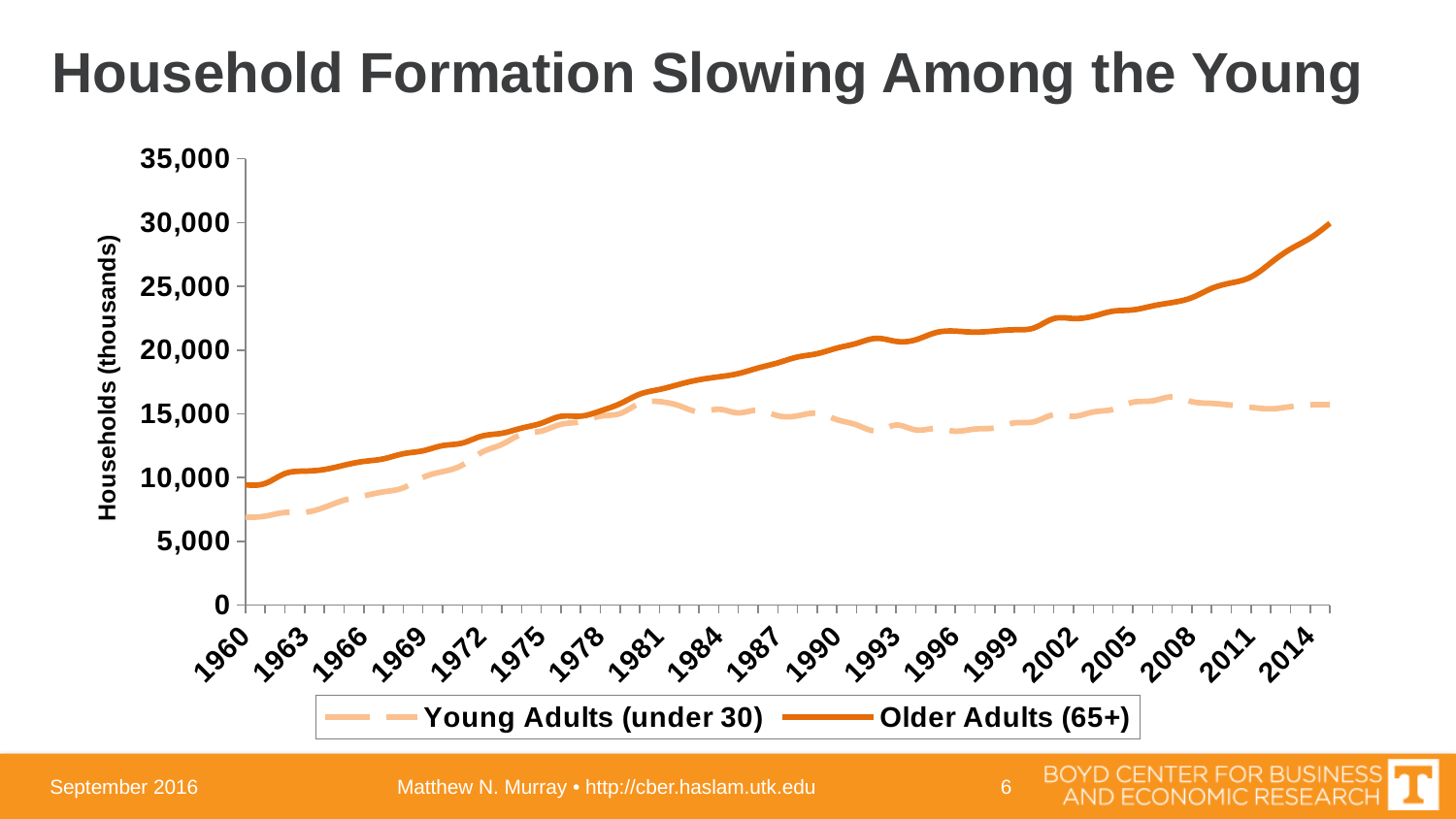
Is the value for Young Adults (under 30) in 1960 greater or less than 10,000? less Is the value for Young Adults (under 30) in 1993 greater or less than 15,000? less In 2014, which series has the higher value, Young Adults (under 30) or Older Adults (65+)? Older Adults (65+) Is the value for Older Adults (65+) in 2005 greater or less than 20,000? greater What kind of chart is shown on the slide? Line chart Does the Older Adults (65+) line generally rise or fall from 1960 to 2014? Rise What are the two series named in the legend? Young Adults (under 30) and Older Adults (65+) In 1960, which series has the higher value, Young Adults (under 30) or Older Adults (65+)? Older Adults (65+) How many series does the legend list? 2 What is the label on the vertical axis? Households (thousands)